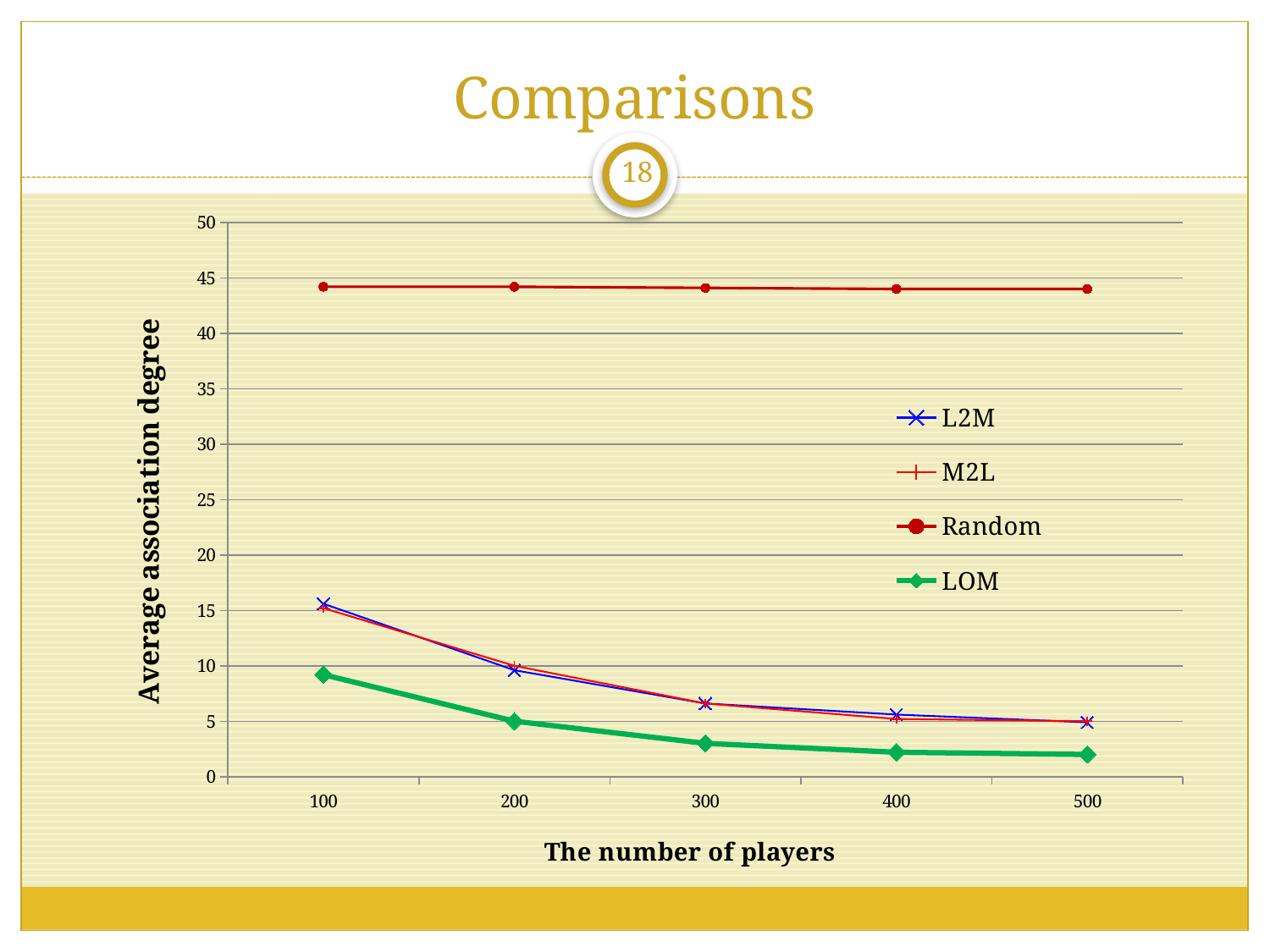
Is the value for LOM at 100 players greater or less than 10? less Which series has the highest average association degree at 100 players? Random Is the value for Random at 300 players greater or less than 40? greater How many series does the legend list? 4 Do the values for L2M rise or fall as the number of players increases from 100 to 500? fall Which is larger at 400 players, the value for Random or the value for LOM? Random What is the title of the x axis? The number of players Which series has the lowest average association degree at 500 players? LOM Do the values for LOM rise or fall as the number of players increases? fall How many values of the number of players are plotted along the x axis? 5 What kind of chart is shown on the slide? line chart Is the value for L2M at 100 players greater or less than 20? less